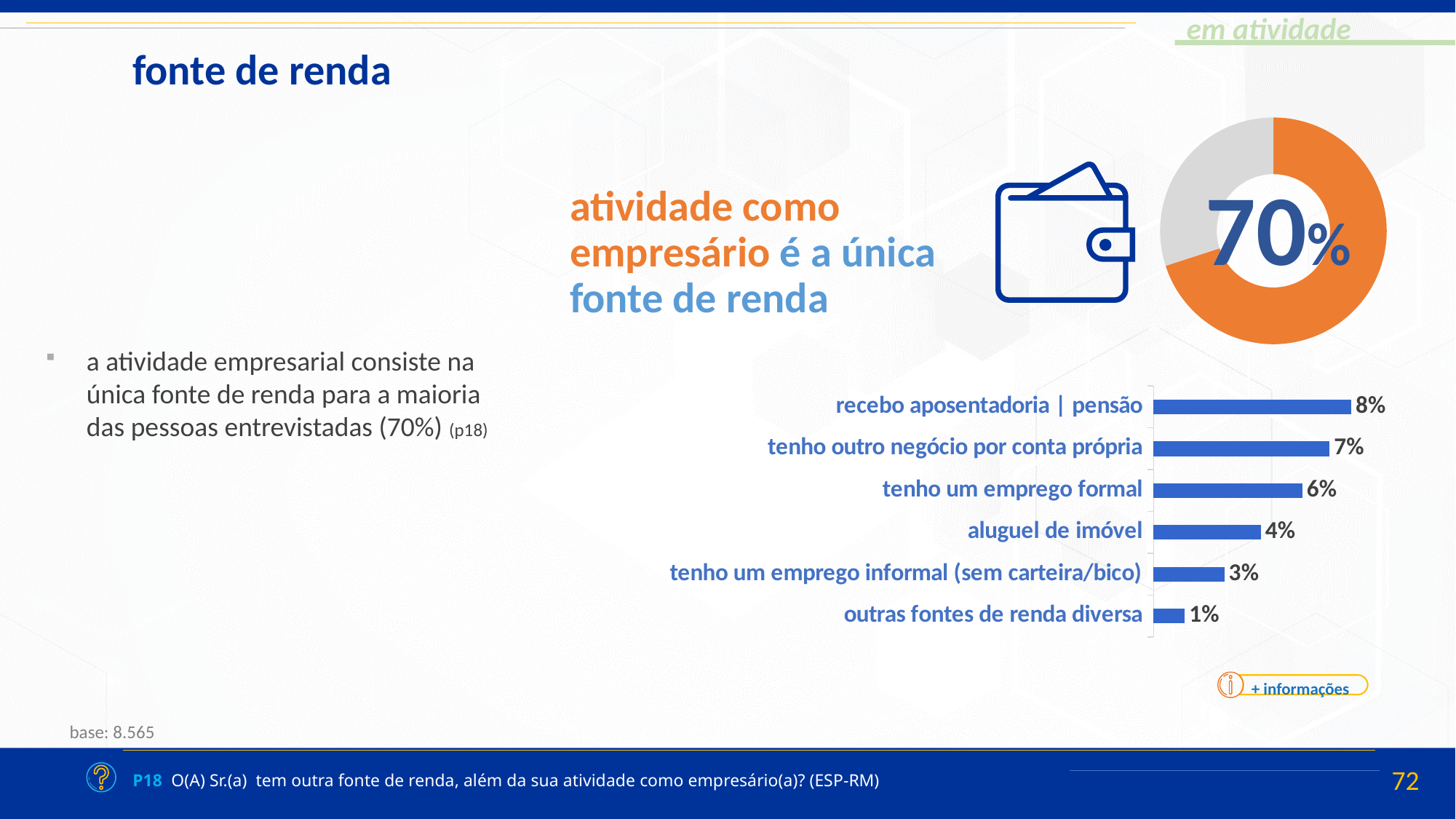
What percentage is shown in the centre of the donut chart at the top right? 70% What kind of chart is the one at the top right showing 70%? donut chart In the horizontal bar chart, what is the value for "recebo aposentadoria | pensão"? 8% In the horizontal bar chart, which category has the lowest value? outras fontes de renda diversa In the horizontal bar chart, what is the value for "tenho um emprego informal (sem carteira/bico)"? 3% What kind of chart is the one listing "recebo aposentadoria | pensão" and other income sources? bar chart In the horizontal bar chart, which is larger: "tenho outro negócio por conta própria" or "aluguel de imóvel"? tenho outro negócio por conta própria In the horizontal bar chart, what is the value for "aluguel de imóvel"? 4% How many categories does the horizontal bar chart show? 6 In the horizontal bar chart, which category has the highest value? recebo aposentadoria | pensão In the horizontal bar chart, do the values rise or fall from the top category to the bottom category? fall In the horizontal bar chart, what is the difference between "recebo aposentadoria | pensão" and "tenho um emprego formal"? 2%